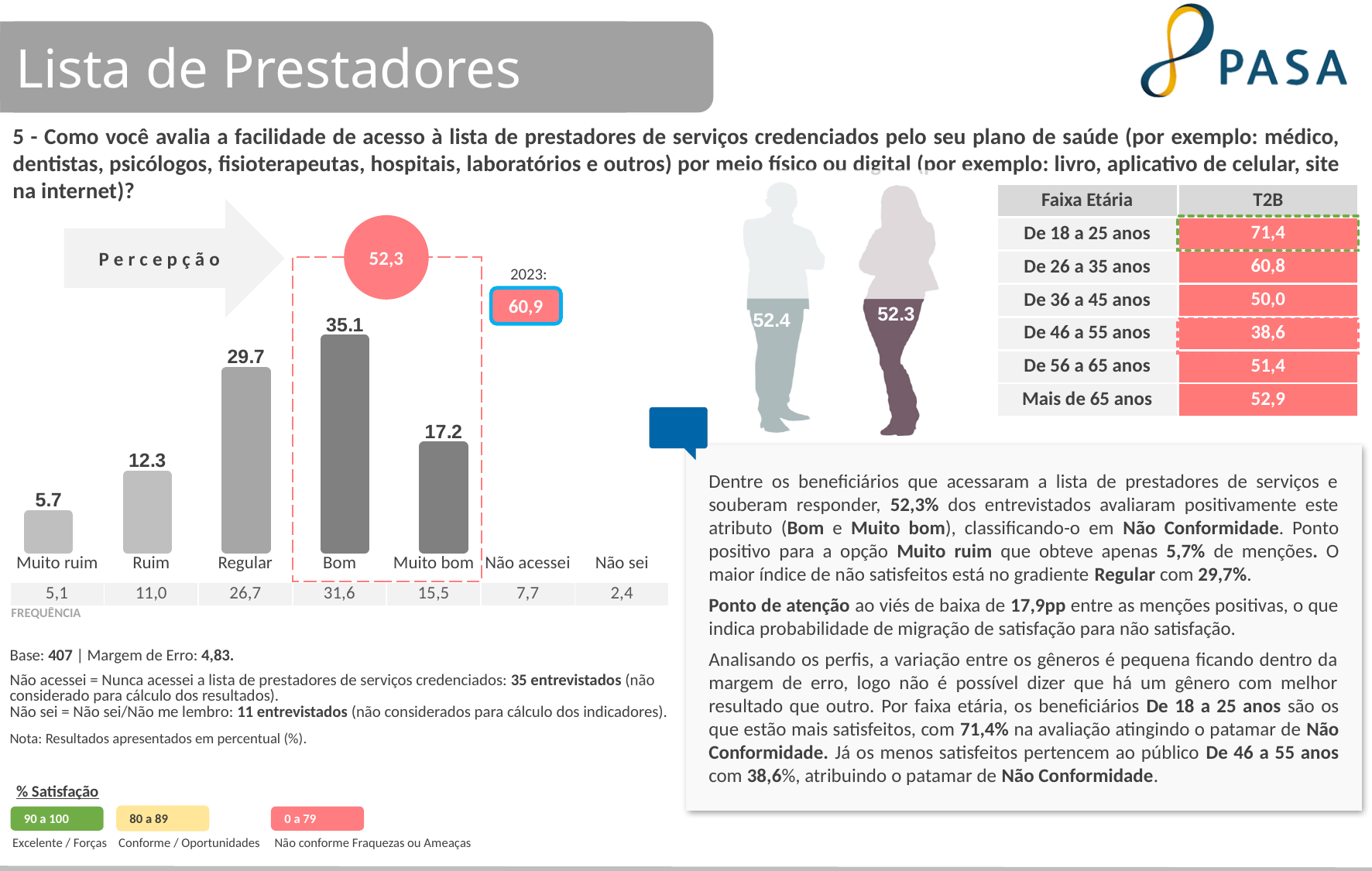
Which category has the lowest bar in the chart? Muito ruim What is the value shown for the 'Regular' bar? 29.7 What kind of chart is shown on the slide? Bar chart Which is larger, the 'Regular' bar or the 'Muito bom' bar? Regular What is the value shown for the 'Muito ruim' bar? 5.7 What is the value shown for the 'Bom' bar? 35.1 How many bars are plotted in the chart? 5 What is the difference between the 'Bom' and 'Muito bom' bar values? 17.9 What is the difference between the 'Ruim' and 'Muito ruim' bar values? 6.6 What value is shown in the circle above the dashed box grouping 'Bom' and 'Muito bom'? 52,3 What value is shown in the box labelled '2023:'? 60,9 Which category has the highest bar in the chart? Bom